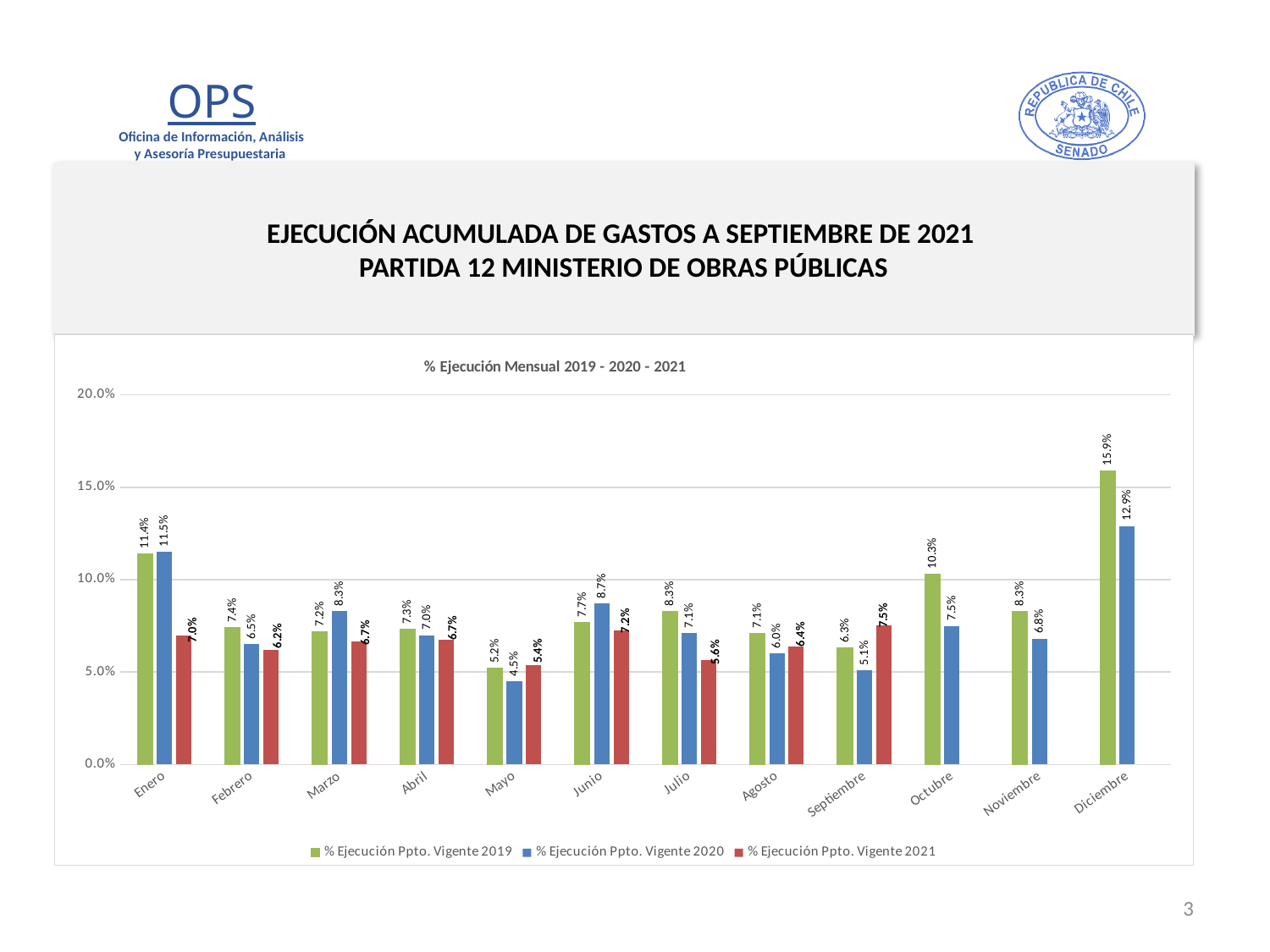
How many months are shown on the x axis? 12 How many series does the legend list? 3 What is the value for % Ejecución Ppto. Vigente 2021 in Enero? 7.0% What is the title of the chart? % Ejecución Mensual 2019 - 2020 - 2021 What kind of chart is shown on the slide? Bar chart What is the value for % Ejecución Ppto. Vigente 2019 in Octubre? 10.3% Which month has the lowest value for % Ejecución Ppto. Vigente 2020? Mayo In Septiembre, which series has the larger value: % Ejecución Ppto. Vigente 2019 or % Ejecución Ppto. Vigente 2021? % Ejecución Ppto. Vigente 2021 Is the value for % Ejecución Ppto. Vigente 2019 in Diciembre greater or less than 15.0%? greater Which month has the highest value for % Ejecución Ppto. Vigente 2019? Diciembre What is the value for % Ejecución Ppto. Vigente 2020 in Junio? 8.7% What is the difference between the 2019 and 2020 values in Diciembre? 3.0%